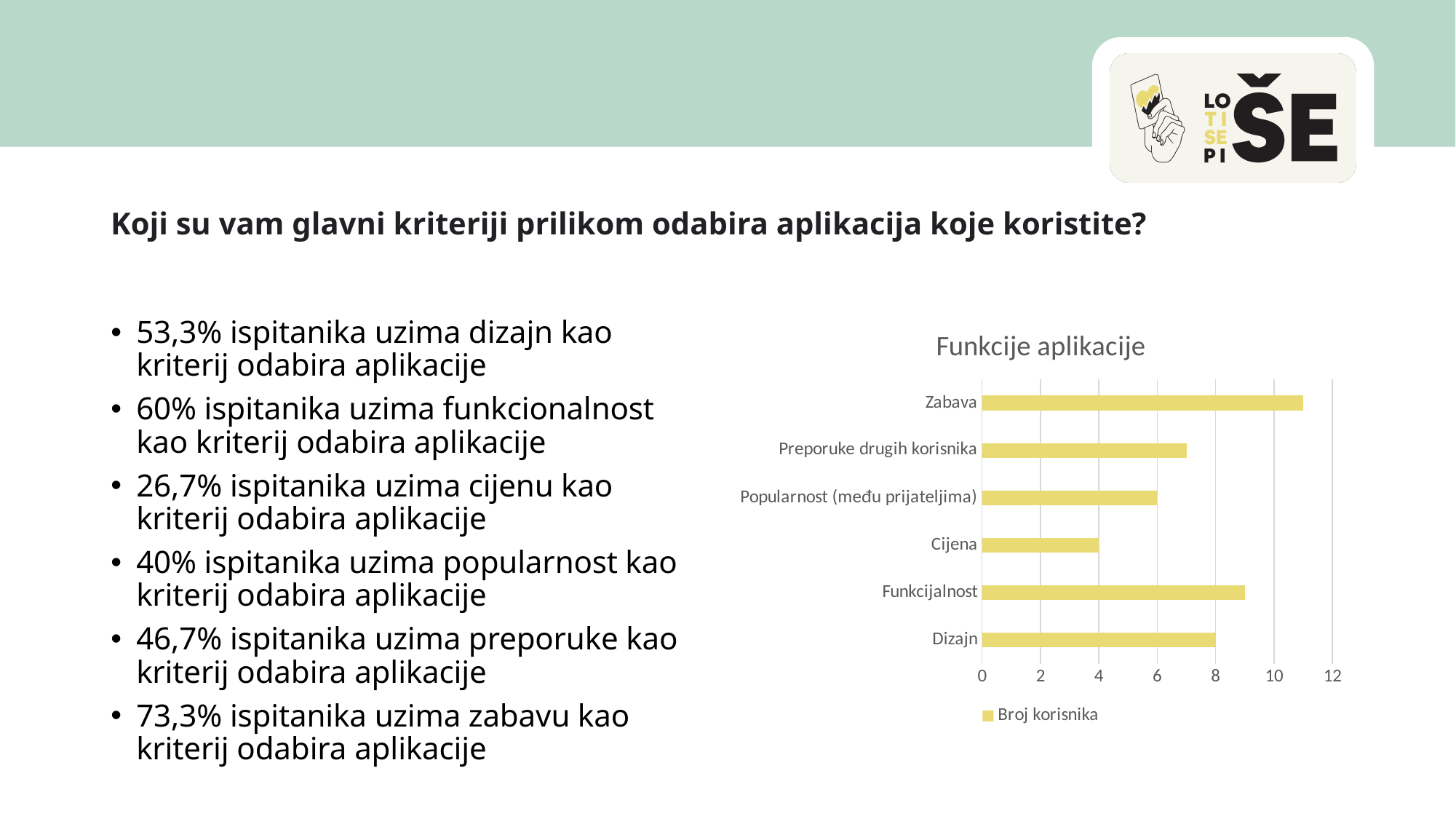
How many series does the chart legend list? 1 Which category has the highest value in the chart? Zabava What type of chart is shown on the slide? bar chart Which has a larger value, Funkcijalnost or Preporuke drugih korisnika? Funkcijalnost What series name does the chart legend show? Broj korisnika What is the value for Cijena? 4 Is the value for Zabava greater or less than 10? greater What is the title of the chart? Funkcije aplikacije What is the value for Dizajn? 8 How many categories are plotted in the chart? 6 What is the difference between the values for Dizajn and Cijena? 4 Which category has the lowest value in the chart? Cijena